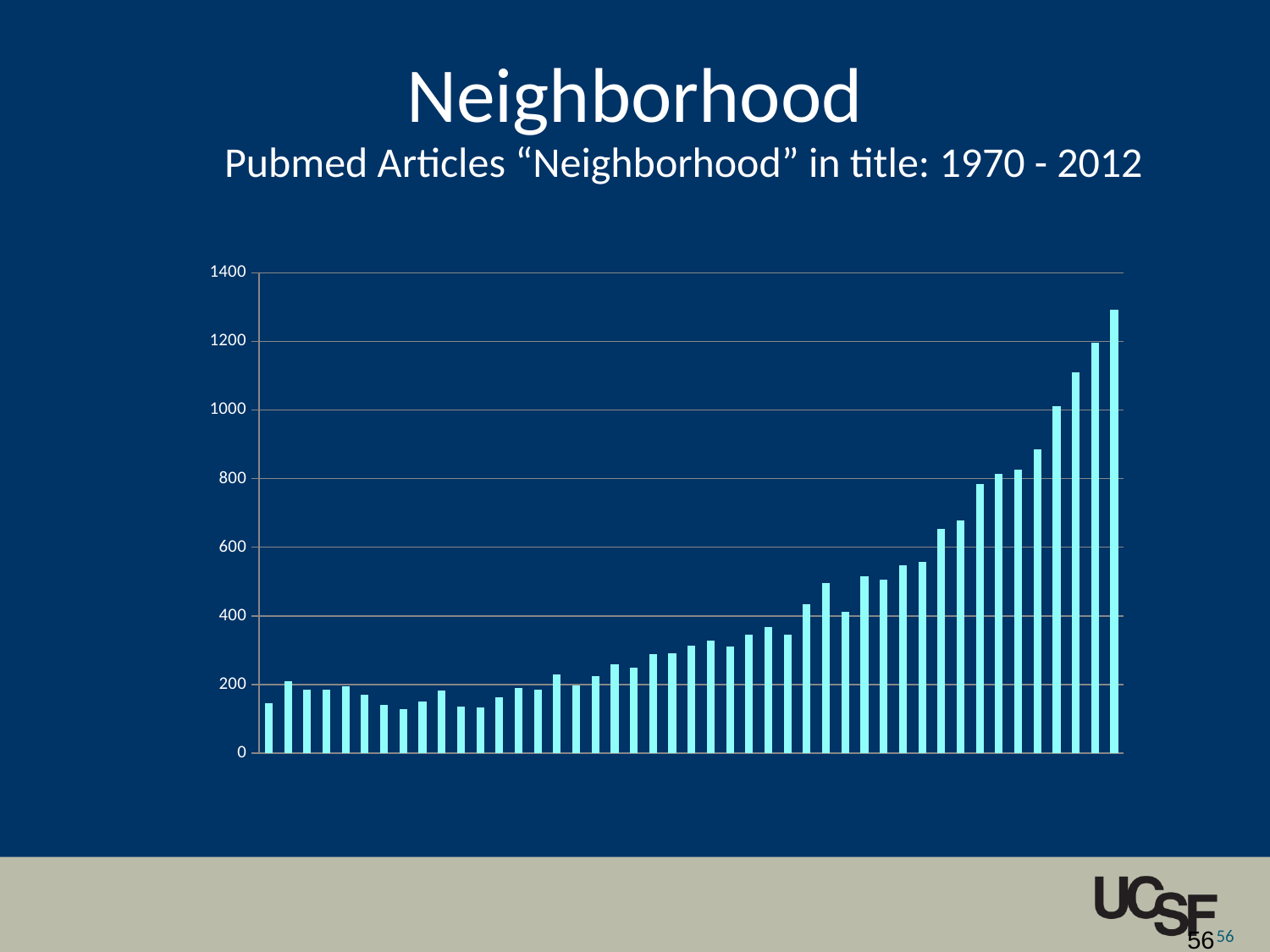
How many bars are plotted in the chart? 45 Which is larger, the leftmost bar or the rightmost bar? the rightmost bar What kind of chart is shown on the slide? bar chart Is the value of the rightmost bar greater or less than 1400? less Which bar is the highest in the chart? the rightmost bar What is the highest value shown on the vertical axis? 1400 Is the value of the rightmost bar greater or less than 1200? greater Is the value of the leftmost bar greater or less than 200? less Do the values generally rise or fall from left to right across the chart? rise What range of years does the chart subtitle say the data covers? 1970 - 2012